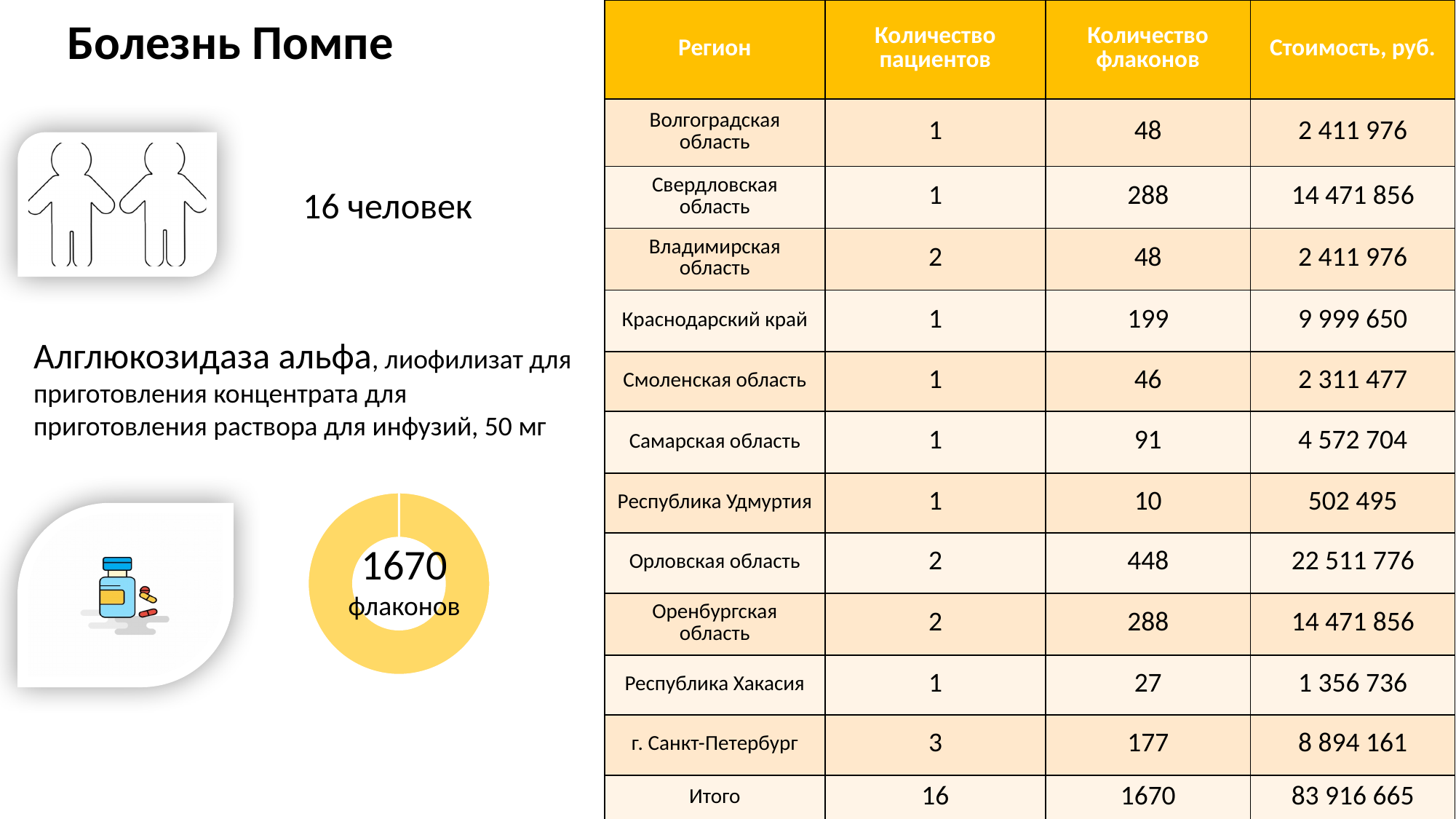
How many visible slices make up the doughnut chart? 1 What number is displayed in the centre of the doughnut chart? 1670 What kind of chart is shown on the left side of the slide next to the medicine icon? doughnut chart What colour is the ring of the doughnut chart? yellow What unit label appears under the number in the centre of the doughnut chart? флаконов Is the value shown in the centre of the doughnut chart greater or less than 1000? greater